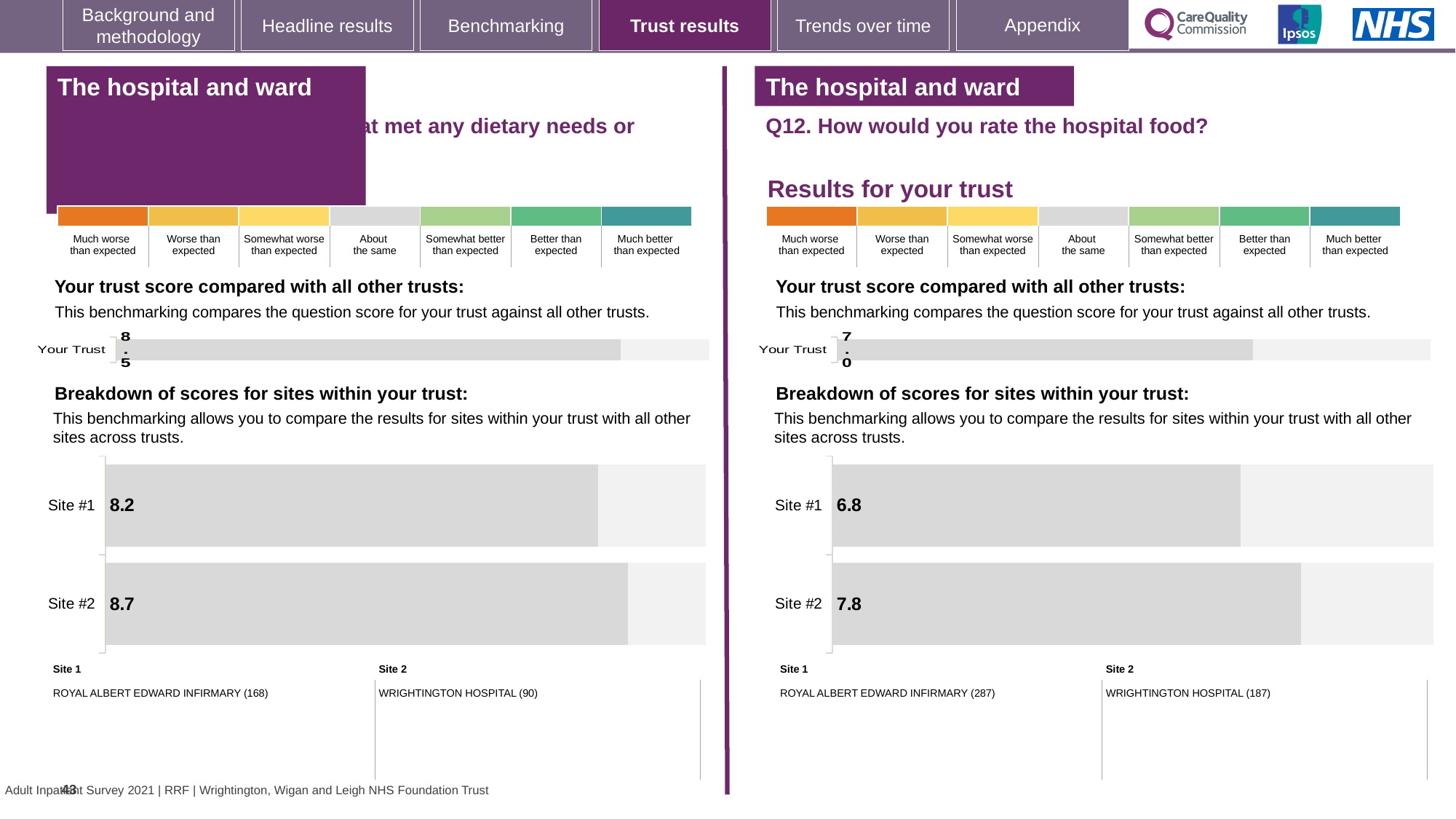
On the right-hand side of the slide (Q12, hospital food), what is the 'Your Trust' score in the trust score comparison chart? 7.0 On the right-hand side of the slide (Q12, hospital food), what is the difference between the Site #2 and Site #1 scores? 1.0 On the right-hand side of the slide (Q12, hospital food), which site has the higher score in the breakdown of scores for sites within your trust? Site #2 On the left-hand side of the slide, what is the difference between the Site #2 and Site #1 scores? 0.5 On the left-hand side of the slide, what is the score shown for Site #2 in the breakdown of scores for sites within your trust? 8.7 On the left-hand side of the slide, which site has the lower score in the breakdown of scores for sites within your trust? Site #1 How many sites are shown in the breakdown of scores chart on the right-hand side of the slide (Q12, hospital food)? 2 On the left-hand side of the slide, what is the 'Your Trust' score in the trust score comparison chart? 8.5 On the left-hand side of the slide, what is the score shown for Site #1 in the breakdown of scores for sites within your trust? 8.2 What type of chart is used for the breakdown of scores for sites within your trust on the right-hand side of the slide? Bar chart On the right-hand side of the slide (Q12, hospital food), what is the score shown for Site #2 in the breakdown of scores for sites within your trust? 7.8 On the right-hand side of the slide (Q12, hospital food), what is the score shown for Site #1 in the breakdown of scores for sites within your trust? 6.8